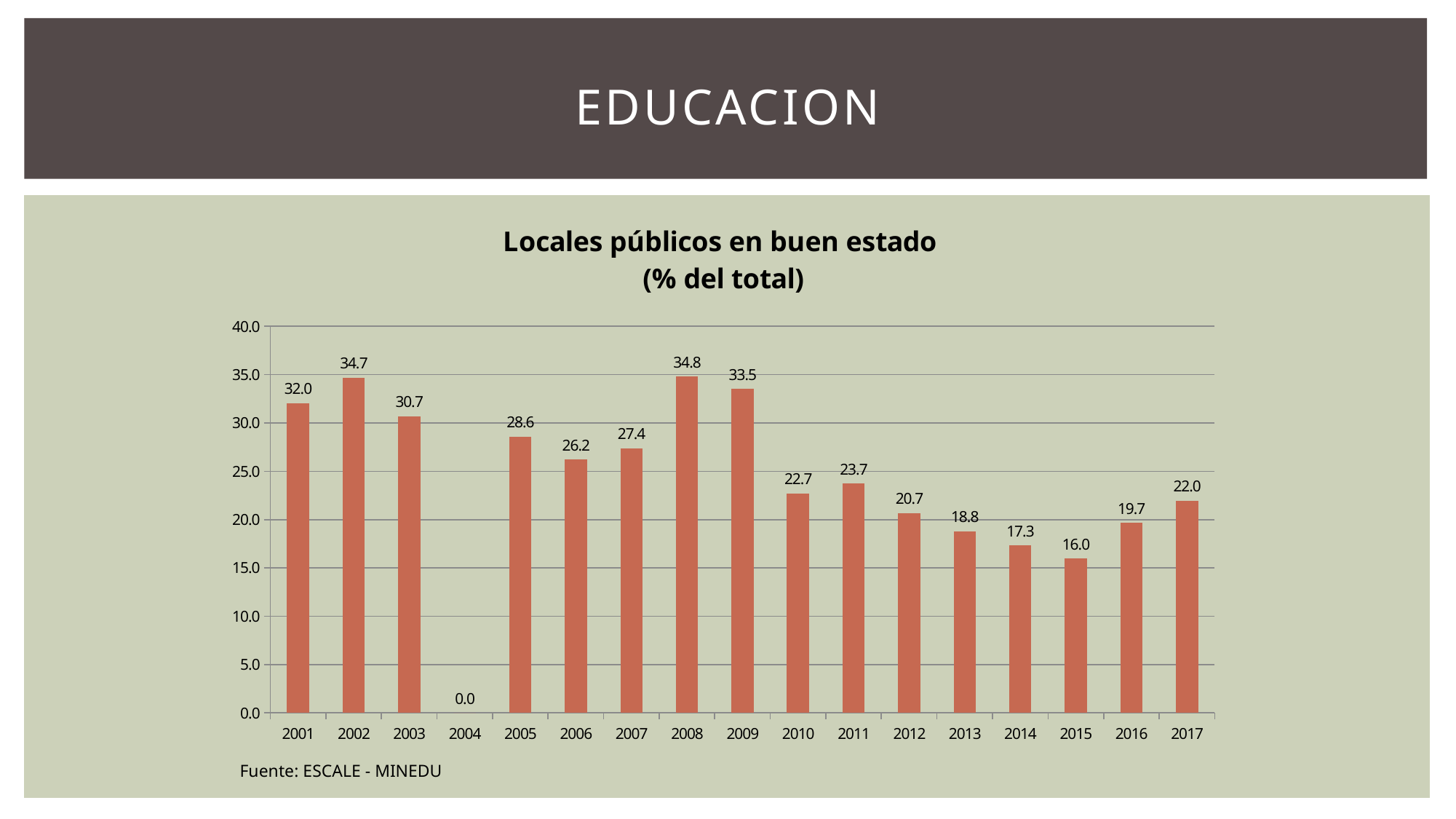
Excluding 2004, which year has the lowest value? 2015 What is the value for 2008? 34.8 What is the value for 2017? 22.0 Which is larger, the value for 2010 or the value for 2011? 2011 Do the values generally rise or fall from 2009 to 2015? fall Which year has the highest value? 2008 What is the difference between the values for 2002 and 2003? 4.0 What kind of chart is this? bar chart How many years are shown on the x axis? 17 Is the value for 2013 greater or less than 20.0? less What is the value for 2015? 16.0 What is the title of the chart? Locales públicos en buen estado (% del total)